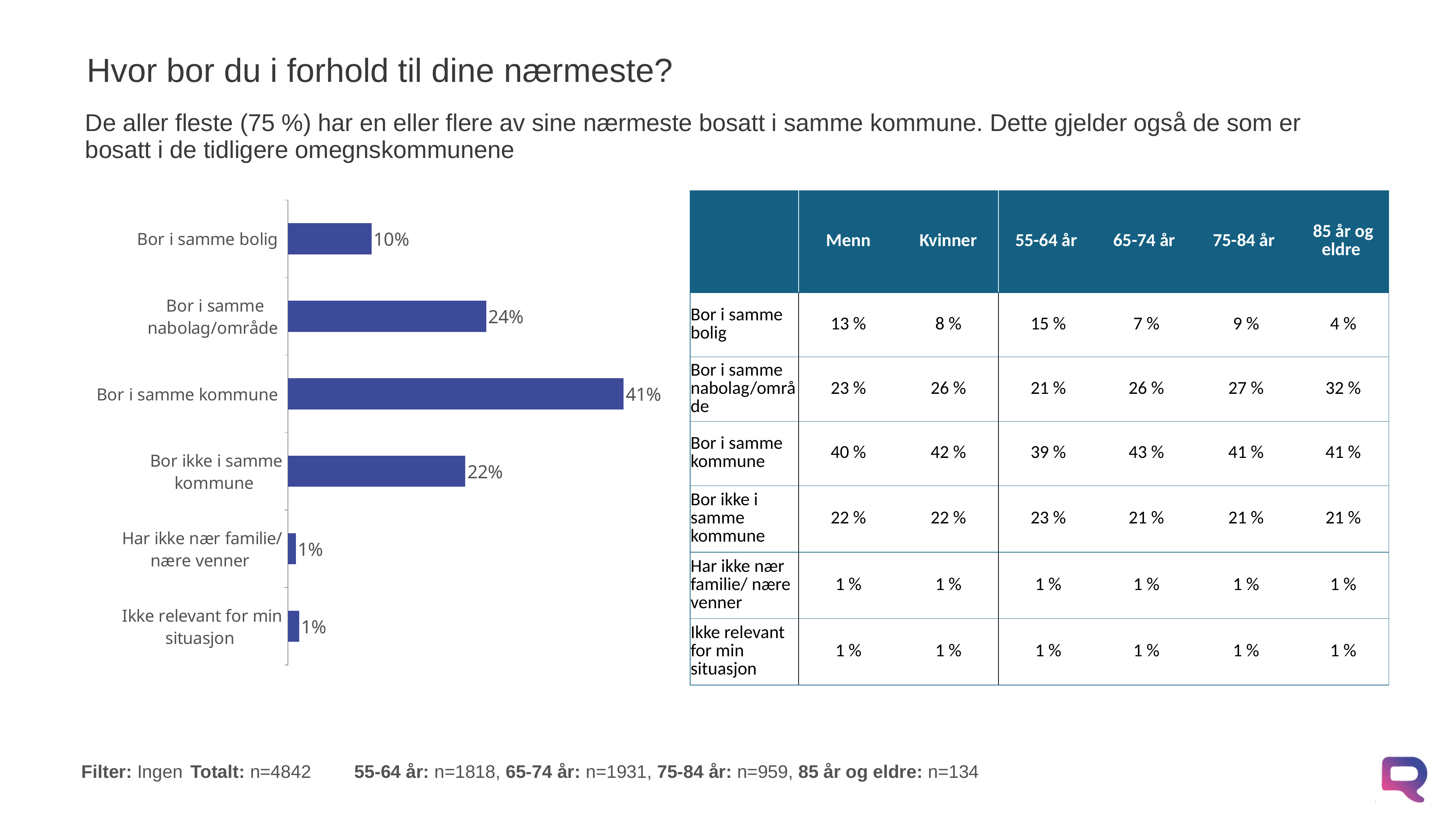
What is the value for "Bor ikke i samme kommune" in the bar chart? 22% What is the value for "Bor i samme nabolag/område" in the bar chart? 24% What is the difference between "Bor i samme nabolag/område" and "Bor ikke i samme kommune" in the bar chart? 2% What is the value for "Har ikke nær familie/ nære venner" in the bar chart? 1% Which is larger in the bar chart: "Bor i samme bolig" or "Bor ikke i samme kommune"? Bor ikke i samme kommune What is the value for "Bor i samme kommune" in the bar chart? 41% What is the value for "Bor i samme bolig" in the bar chart? 10% What is the difference between "Bor i samme kommune" and "Bor i samme nabolag/område" in the bar chart? 17% What kind of chart is shown on the slide? Bar chart How many categories are shown in the bar chart? 6 What is the combined value of "Bor i samme bolig", "Bor i samme nabolag/område" and "Bor i samme kommune" in the bar chart? 75% Which category has the highest value in the bar chart? Bor i samme kommune